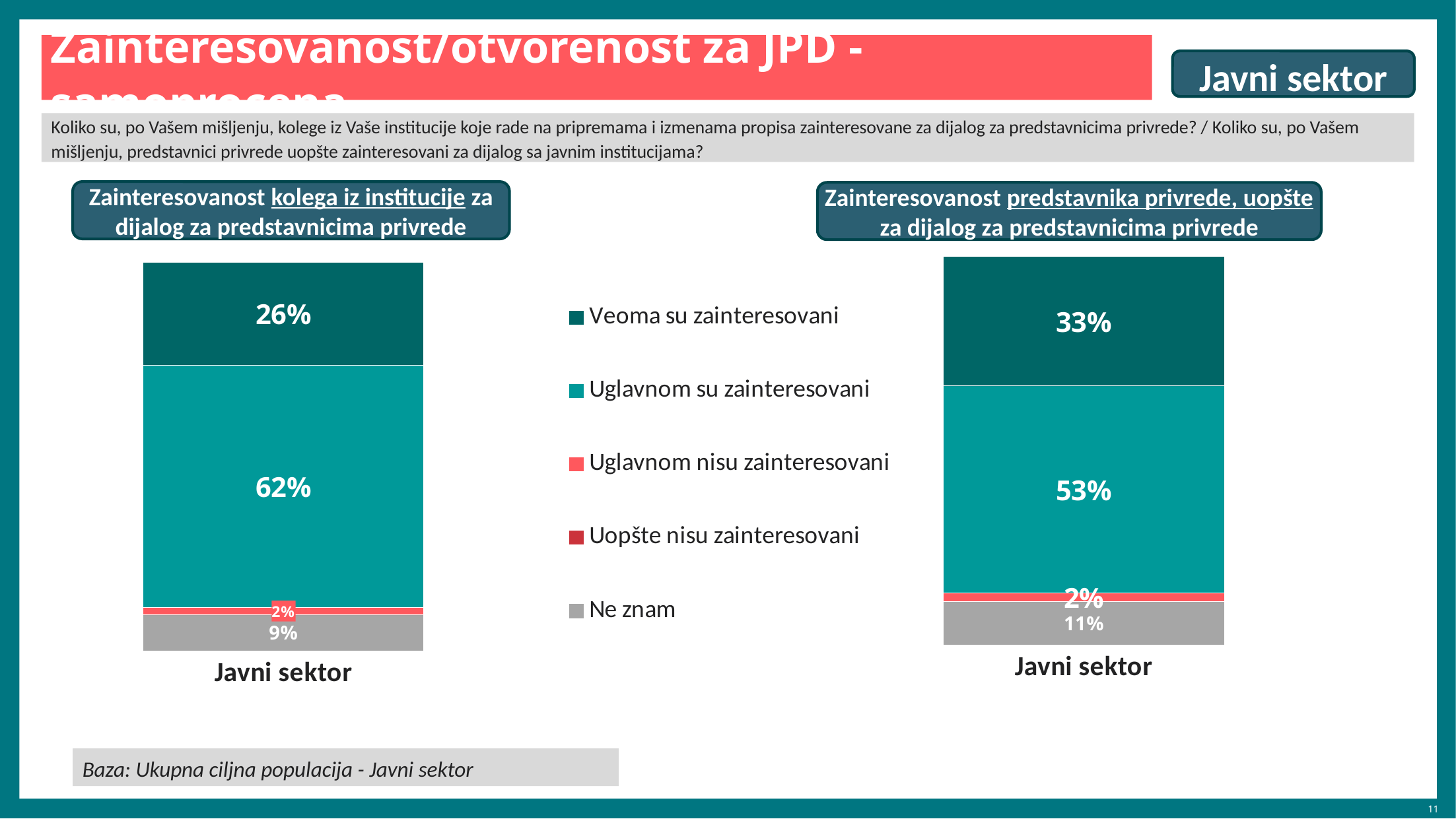
In the left chart (Zainteresovanost kolega iz institucije), what percentage is shown for 'Veoma su zainteresovani'? 26% In the left chart (Zainteresovanost kolega iz institucije), what percentage is shown for 'Uglavnom su zainteresovani'? 62% What type of chart is used on this slide? Stacked bar chart In the right chart (Zainteresovanost predstavnika privrede), what percentage is shown for 'Uglavnom su zainteresovani'? 53% In the left chart (Zainteresovanost kolega iz institucije), what percentage is shown for 'Ne znam'? 9% Which chart shows a higher value for 'Veoma su zainteresovani', the left chart or the right chart? The right chart In the left chart (Zainteresovanost kolega iz institucije), what is the difference between 'Uglavnom su zainteresovani' and 'Veoma su zainteresovani'? 36 percentage points How many entries does the shared legend list? 5 In the left chart (Zainteresovanost kolega iz institucije), which response category has the largest share? Uglavnom su zainteresovani In the right chart (Zainteresovanost predstavnika privrede), what percentage is shown for 'Ne znam'? 11% In the right chart (Zainteresovanost predstavnika privrede), which response category has the largest share? Uglavnom su zainteresovani In the right chart (Zainteresovanost predstavnika privrede), what percentage is shown for 'Veoma su zainteresovani'? 33%